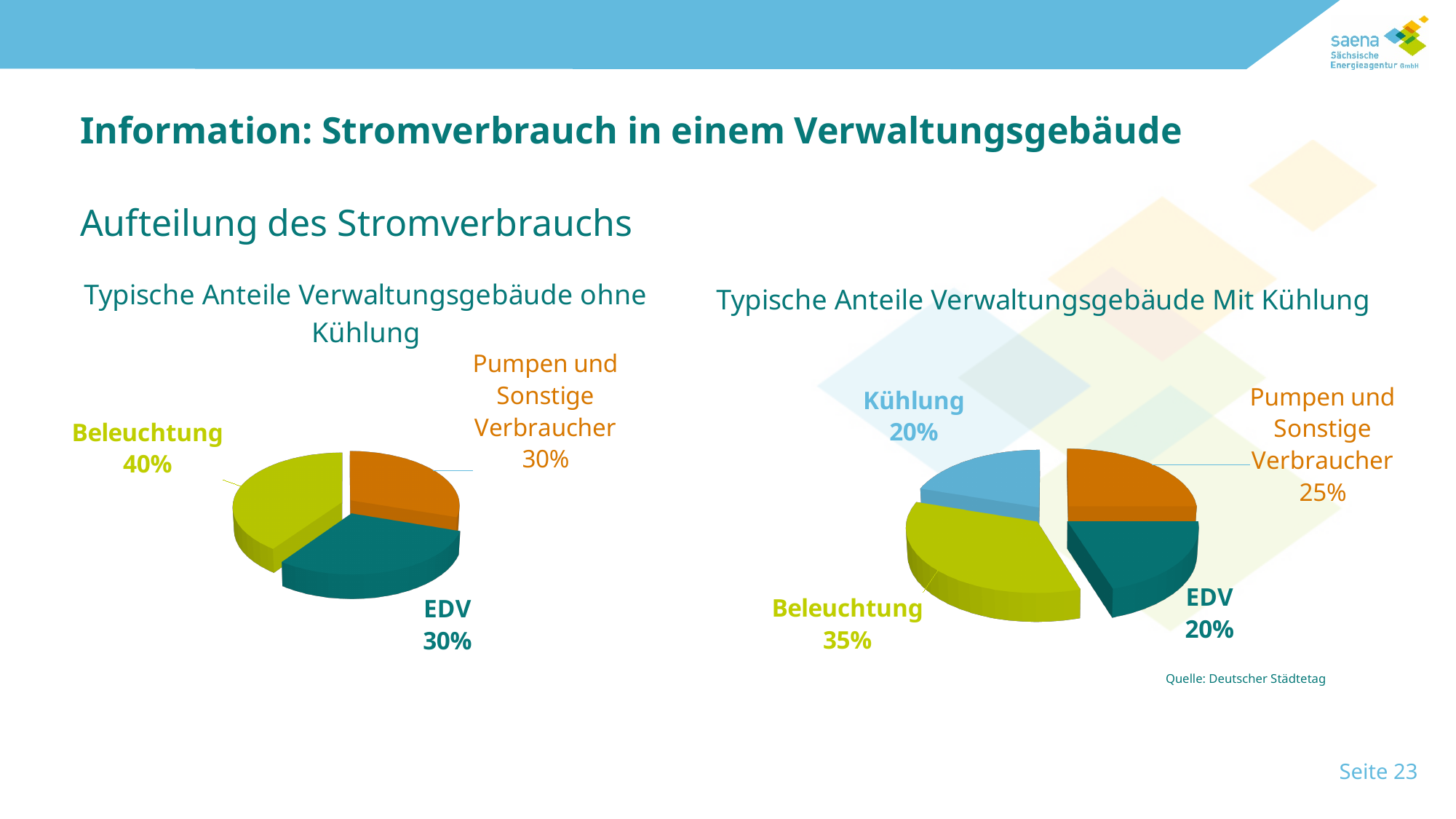
How many slices does the chart 'Typische Anteile Verwaltungsgebäude Mit Kühlung' have? 4 How many slices does the chart 'Typische Anteile Verwaltungsgebäude ohne Kühlung' have? 3 In the chart 'Typische Anteile Verwaltungsgebäude Mit Kühlung', what share does Kühlung have? 20% In the chart 'Typische Anteile Verwaltungsgebäude Mit Kühlung', what share does Pumpen und Sonstige Verbraucher have? 25% In the chart 'Typische Anteile Verwaltungsgebäude ohne Kühlung', which category has the largest share? Beleuchtung In the chart 'Typische Anteile Verwaltungsgebäude ohne Kühlung', what share does EDV have? 30% In the chart 'Typische Anteile Verwaltungsgebäude Mit Kühlung', what is the difference between the shares of Beleuchtung and EDV? 15% In the chart 'Typische Anteile Verwaltungsgebäude Mit Kühlung', which is larger: the share of Pumpen und Sonstige Verbraucher or the share of EDV? Pumpen und Sonstige Verbraucher What kind of chart is 'Typische Anteile Verwaltungsgebäude Mit Kühlung'? Pie chart In the chart 'Typische Anteile Verwaltungsgebäude Mit Kühlung', which category has the largest share? Beleuchtung In the chart 'Typische Anteile Verwaltungsgebäude ohne Kühlung', what share does Beleuchtung have? 40% In the chart 'Typische Anteile Verwaltungsgebäude ohne Kühlung', what is the difference between the shares of Beleuchtung and Pumpen und Sonstige Verbraucher? 10%